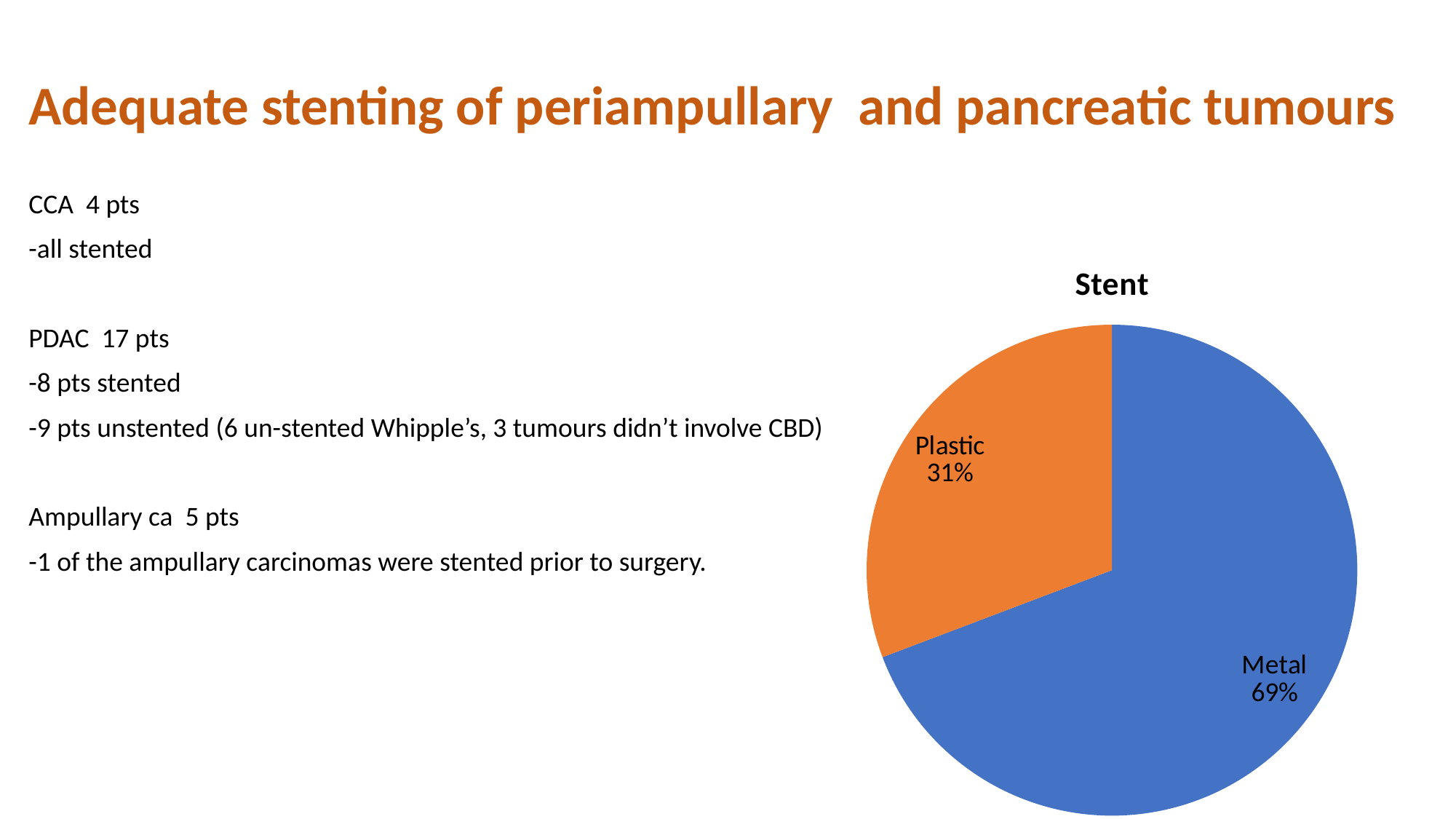
How many slices does the pie chart have? 2 What colour is the Metal slice of the pie? blue What is the title of the chart? Stent Which slice of the pie is the largest? Metal What type of chart is shown on the slide? pie chart Which slice of the pie is the smallest? Plastic What share of the pie does Metal represent? 69% Which is larger, the Metal slice or the Plastic slice? Metal What is the difference in percentage points between the Metal and Plastic slices? 38 What share of the pie does Plastic represent? 31%